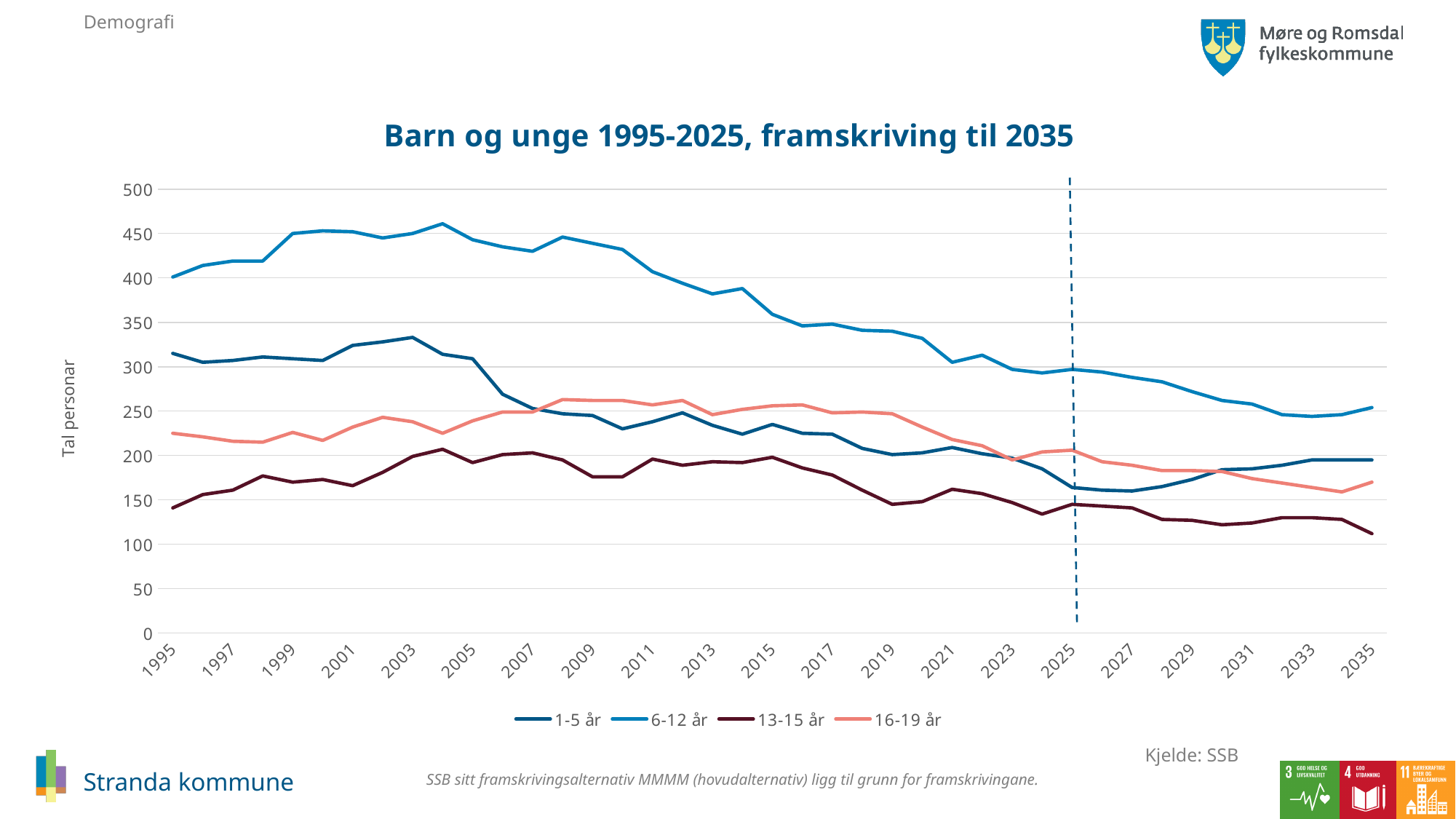
Is the value for 1-5 år in 2035 greater or less than 200? less What is the label on the vertical axis? Tal personar Is the value for 13-15 år in 2035 greater or less than 100? greater What is the title of the chart? Barn og unge 1995-2025, framskriving til 2035 How many series does the legend list? 4 What kind of chart is shown on the slide? line chart Which series has the lowest value in 2025? 13-15 år Is the value for 6-12 år in 2004 greater or less than 450? greater Which series has the highest value in 2025? 6-12 år In 2010, which series has the larger value, 6-12 år or 1-5 år? 6-12 år Does the 6-12 år series rise or fall between 2005 and 2025? fall